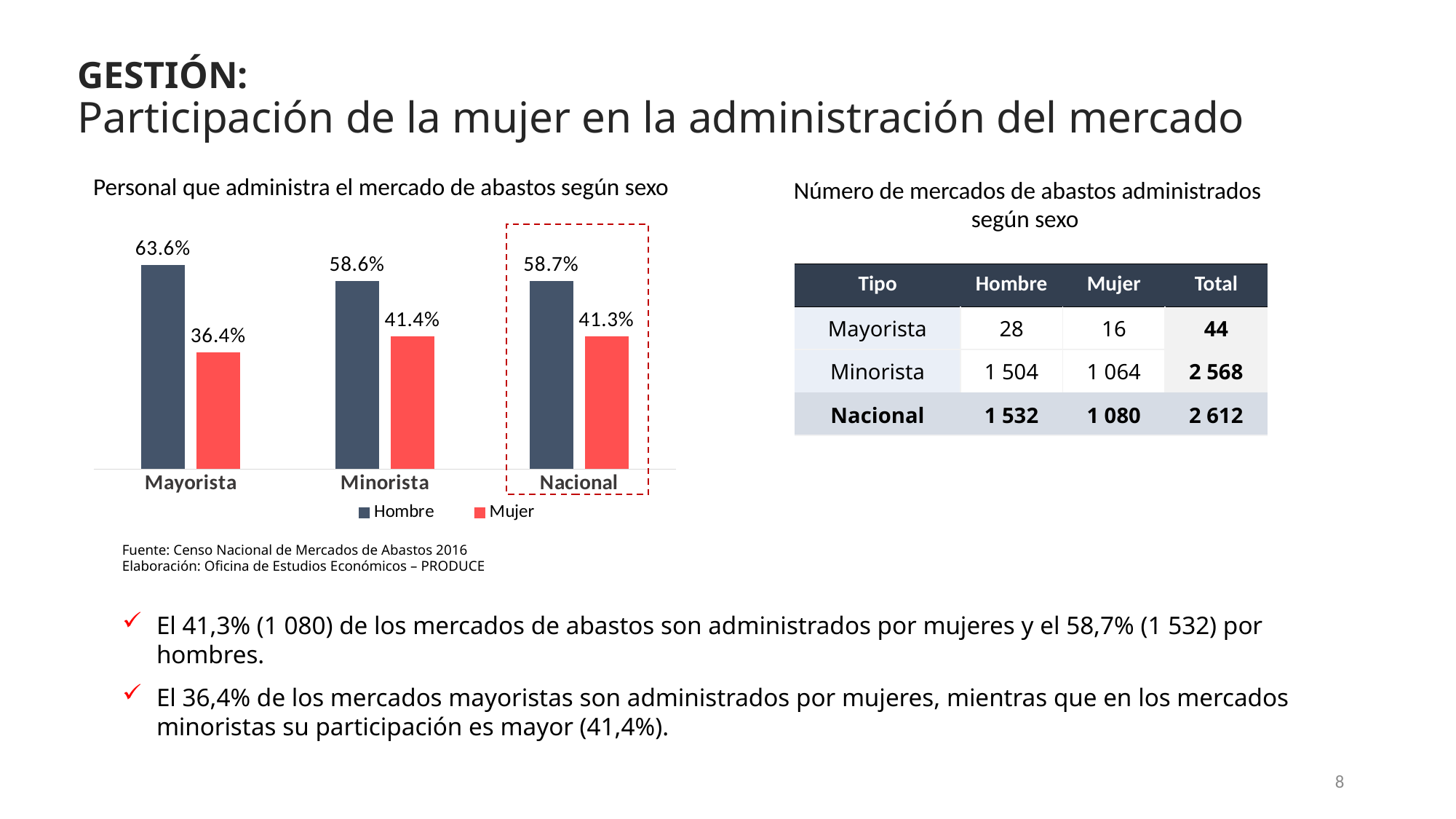
Which category has the lowest Mujer value in the chart? Mayorista What is the Mujer value for Nacional in the chart? 41.3% Which is larger in the chart: the Mujer value for Mayorista or the Mujer value for Minorista? Minorista What kind of chart is shown on the slide? Bar chart How many series does the chart's legend list? 2 What is the Hombre value for Mayorista in the chart? 63.6% Which category has the highest Hombre value in the chart? Mayorista What is the title of the chart on the slide? Personal que administra el mercado de abastos según sexo What is the difference between the Hombre and Mujer values for Mayorista in the chart? 27.2% How many categories are shown on the x axis of the chart? 3 What is the Mujer value for Minorista in the chart? 41.4% What is the Hombre value for Nacional in the chart? 58.7%